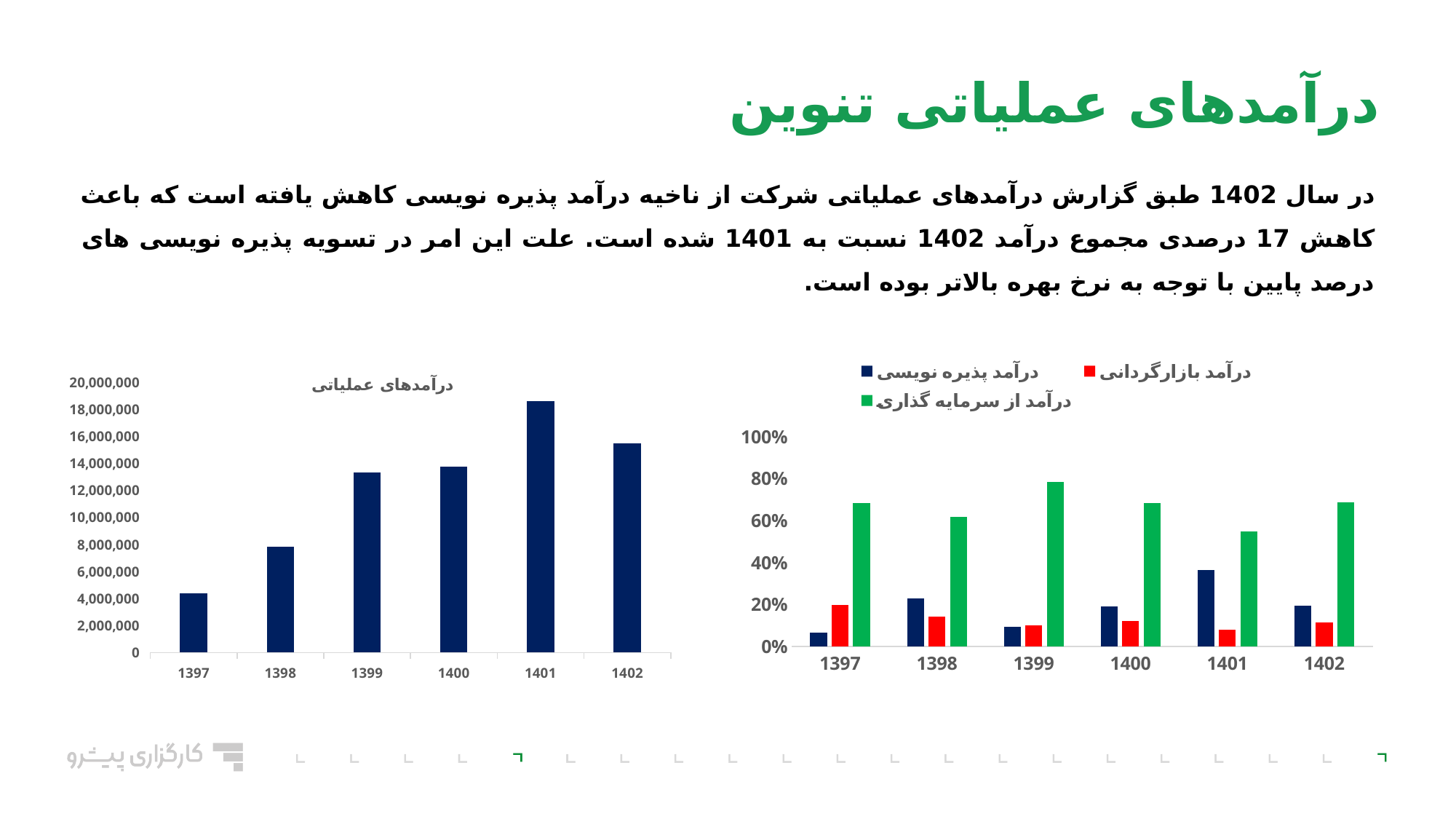
In the left chart (درآمدهای عملیاتی), which year has the lowest value? 1397 In the left chart (درآمدهای عملیاتی), which year has the highest value? 1401 How many series does the legend of the right chart list? 3 In the left chart (درآمدهای عملیاتی), does the value rise or fall from 1401 to 1402? fall In the left chart (درآمدهای عملیاتی), how many years are shown on the x axis? 6 In the left chart (درآمدهای عملیاتی), is the value for 1401 greater or less than 18,000,000? greater What kind of chart is the left chart titled درآمدهای عملیاتی? bar chart In the left chart (درآمدهای عملیاتی), is the value for 1397 greater or less than 6,000,000? less In the right chart, which year has the highest value for درآمد از سرمایه گذاری (green)? 1399 In the right chart, is the value for درآمد پذیره نویسی in 1401 greater or less than 20%? greater In the left chart (درآمدهای عملیاتی), which is larger, the value for 1402 or the value for 1399? 1402 In the right chart, which year has the highest value for درآمد پذیره نویسی (dark blue)? 1401